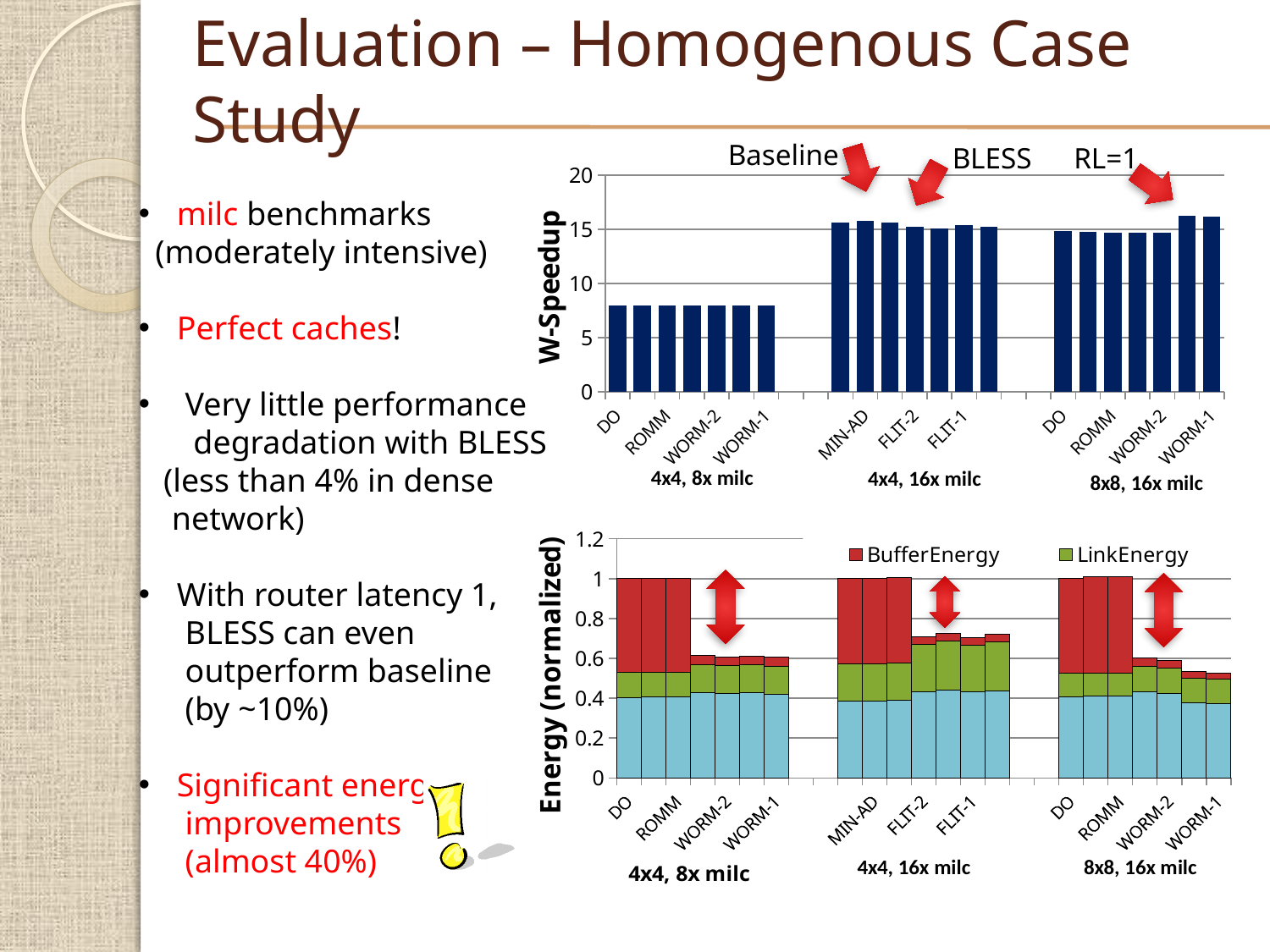
What is the y-axis title of the bottom chart? Energy (normalized) In the top W-Speedup chart, is the value for MIN-AD in the 4x4, 16x milc group greater or less than 10? greater In the top W-Speedup chart, is the value for WORM-1 in the 8x8, 16x milc group greater or less than 15? greater In the bottom Energy (normalized) chart, is the total for WORM-1 in the 8x8, 16x milc group greater or less than 0.6? less How many series does the legend of the bottom Energy chart list? 2 How many bars are in the 4x4, 8x milc group of the top W-Speedup chart? 7 How many benchmark groups (x-axis group labels) does the top W-Speedup chart show? 3 What kind of chart is the top chart (W-Speedup)? bar chart What kind of chart is the bottom chart (Energy (normalized))? stacked bar chart In the top W-Speedup chart, which is larger: DO in the 4x4, 8x milc group or MIN-AD in the 4x4, 16x milc group? MIN-AD in the 4x4, 16x milc group